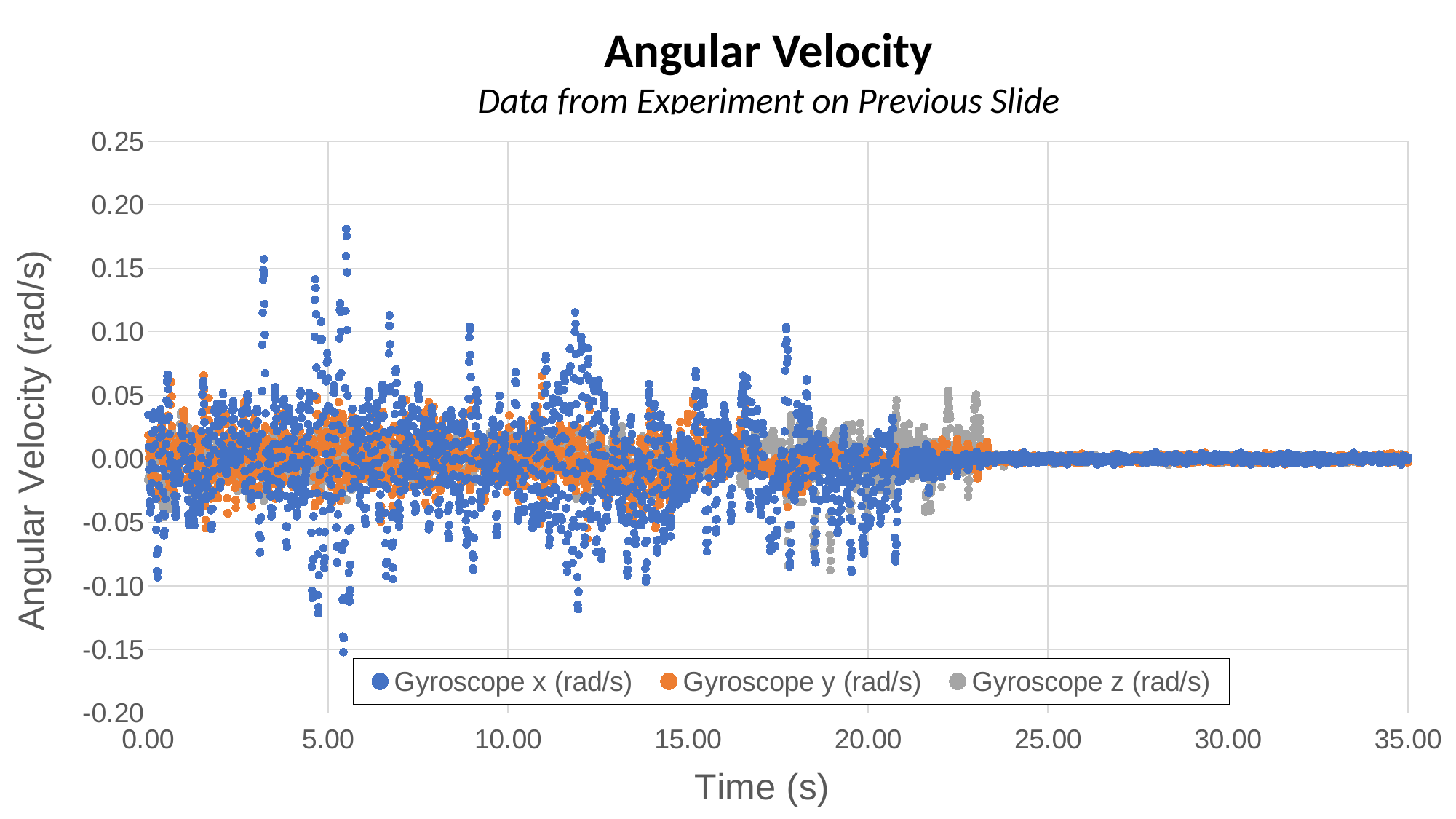
Which series is plotted in blue? Gyroscope x (rad/s) What is the title of the chart? Angular Velocity What kind of chart is shown on the slide? scatter chart What is the label of the y axis? Angular Velocity (rad/s) Is the highest value reached by Gyroscope z (rad/s) greater or less than 0.10? less Is the highest value reached by Gyroscope y (rad/s) greater or less than 0.10? less How many series does the legend list? 3 Do the angular velocity values become more spread out or settle closer to zero as time increases past 25.00 s? settle closer to zero Is the highest value reached by Gyroscope x (rad/s) greater or less than 0.15? greater Which series shows the widest spread of values, Gyroscope x (rad/s) or Gyroscope y (rad/s)? Gyroscope x (rad/s)